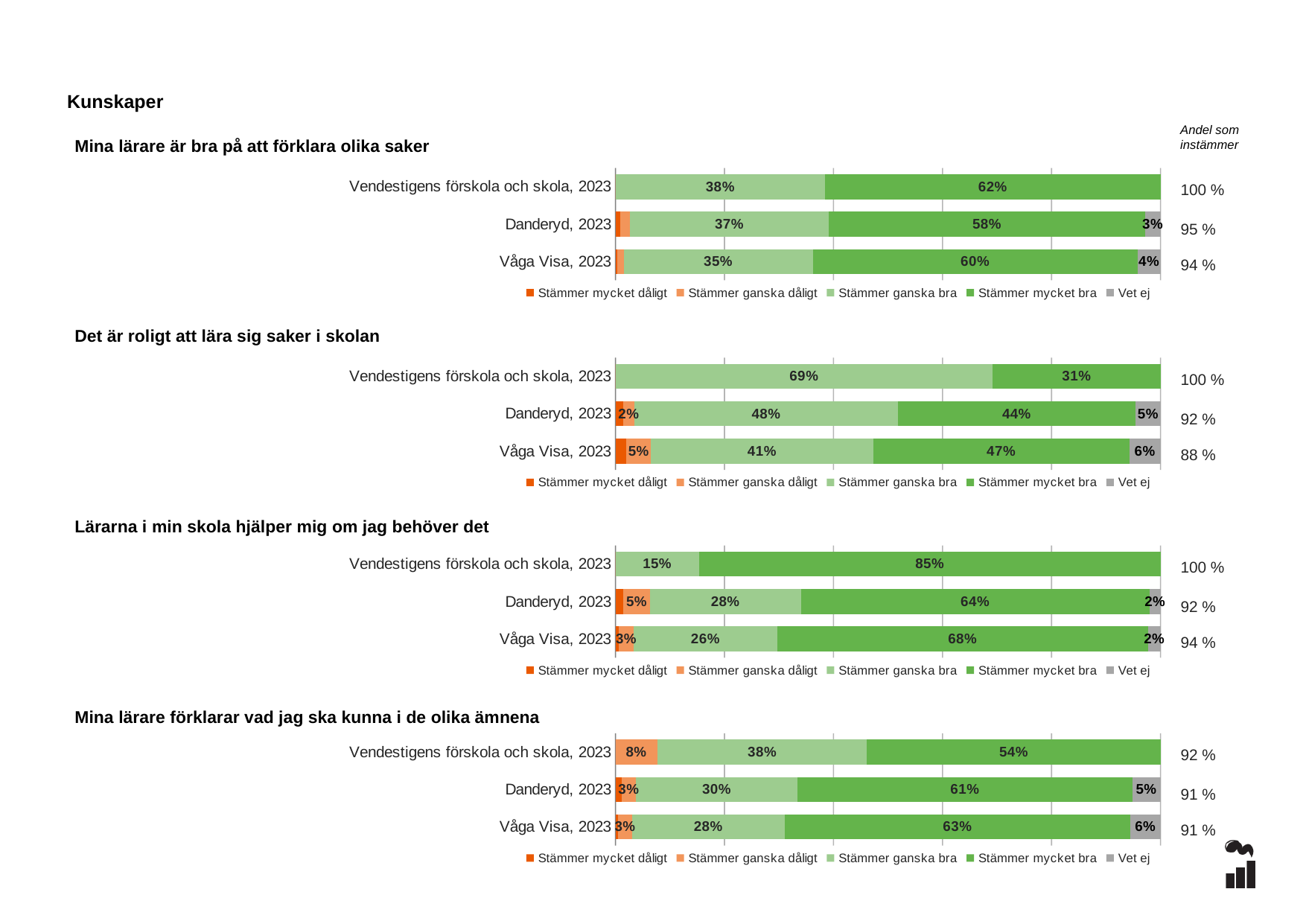
In the chart 'Det är roligt att lära sig saker i skolan', which row has the lowest 'Andel som instämmer' value? Våga Visa, 2023 In the chart 'Det är roligt att lära sig saker i skolan', what is the 'Vet ej' value for Våga Visa, 2023? 6% In the chart 'Lärarna i min skola hjälper mig om jag behöver det', which row has the highest 'Stämmer mycket bra' value? Vendestigens förskola och skola, 2023 What kind of chart is 'Det är roligt att lära sig saker i skolan'? Stacked bar chart In the chart 'Lärarna i min skola hjälper mig om jag behöver det', what is the 'Stämmer mycket bra' value for Vendestigens förskola och skola, 2023? 85% In the chart 'Lärarna i min skola hjälper mig om jag behöver det', what is the difference between the 'Stämmer mycket bra' values for Våga Visa, 2023 and Danderyd, 2023? 4% In the chart 'Det är roligt att lära sig saker i skolan', what is the 'Stämmer ganska bra' value for Vendestigens förskola och skola, 2023? 69% How many series does the legend list for the chart 'Mina lärare är bra på att förklara olika saker'? 5 In the chart 'Mina lärare förklarar vad jag ska kunna i de olika ämnena', which is larger: the 'Stämmer mycket bra' value for Danderyd, 2023 or for Våga Visa, 2023? Våga Visa, 2023 In the chart 'Mina lärare förklarar vad jag ska kunna i de olika ämnena', what is the 'Stämmer ganska dåligt' value for Vendestigens förskola och skola, 2023? 8% In the chart 'Mina lärare är bra på att förklara olika saker', what is the 'Stämmer ganska bra' value for Våga Visa, 2023? 35% In the chart 'Mina lärare är bra på att förklara olika saker', what is the 'Stämmer mycket bra' value for Vendestigens förskola och skola, 2023? 62%